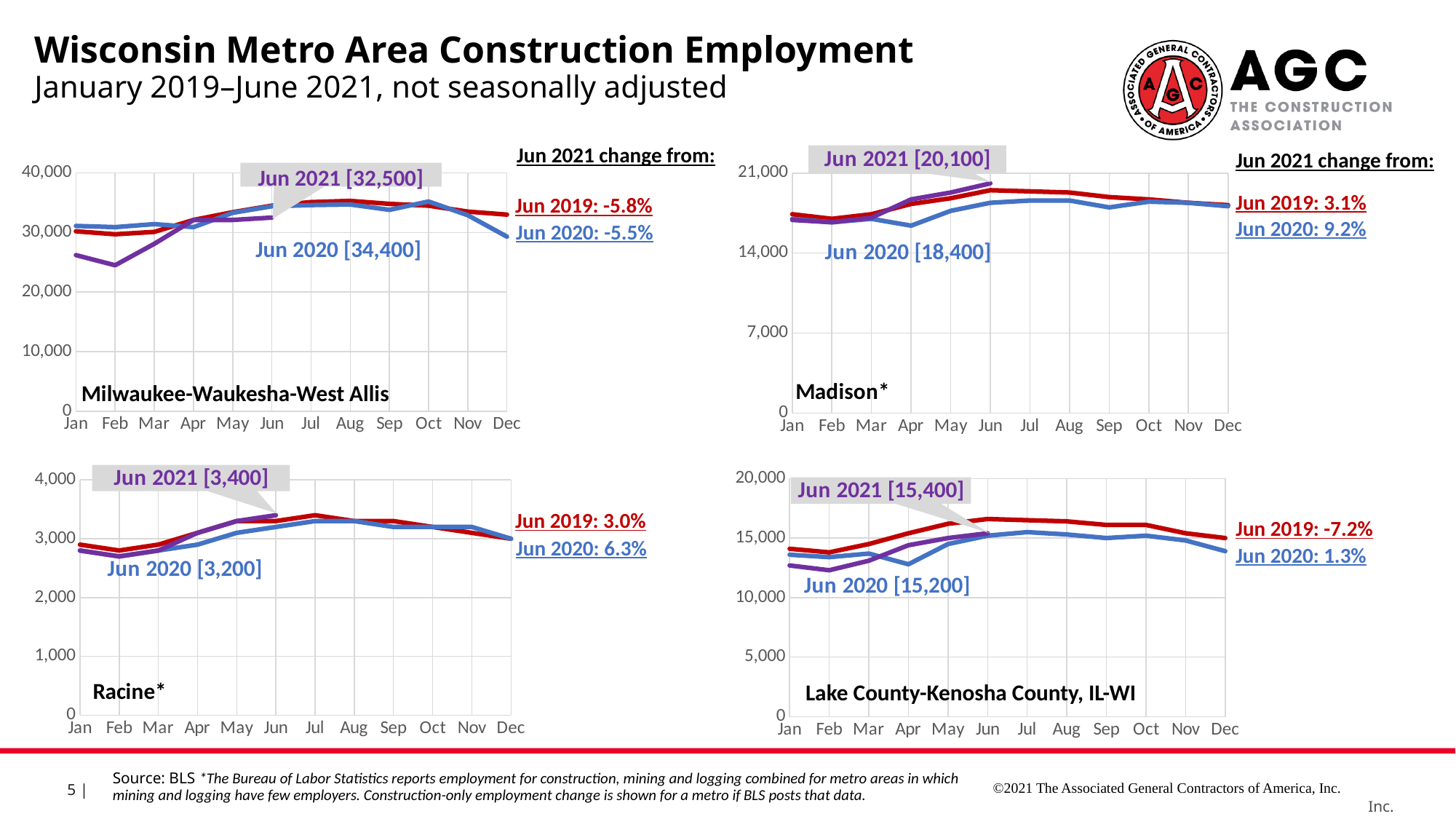
In the Milwaukee-Waukesha-West Allis chart, which is larger, the Jun 2020 value or the Jun 2021 value? Jun 2020 In the Madison chart, what is the difference between the Jun 2021 value and the Jun 2020 value? 1,700 What kind of chart is the Milwaukee-Waukesha-West Allis chart? line chart In the Madison chart, what is the Jun 2021 change from Jun 2020? 9.2% How many months are shown on the x axis of the Racine chart? 12 In the Racine chart, what is the Jun 2021 change from Jun 2019? 3.0% In the Milwaukee-Waukesha-West Allis chart, what is the Jun 2020 value? 34,400 In the Lake County-Kenosha County, IL-WI chart, what is the difference between the Jun 2021 value and the Jun 2020 value? 200 In the Lake County-Kenosha County, IL-WI chart, is the Feb value of the 2021 (purple) line greater or less than 10,000? greater In the Racine chart, what is the Jun 2020 value? 3,200 In the Madison chart, what is the Jun 2021 value? 20,100 In the Milwaukee-Waukesha-West Allis chart, what is the Jun 2021 value? 32,500